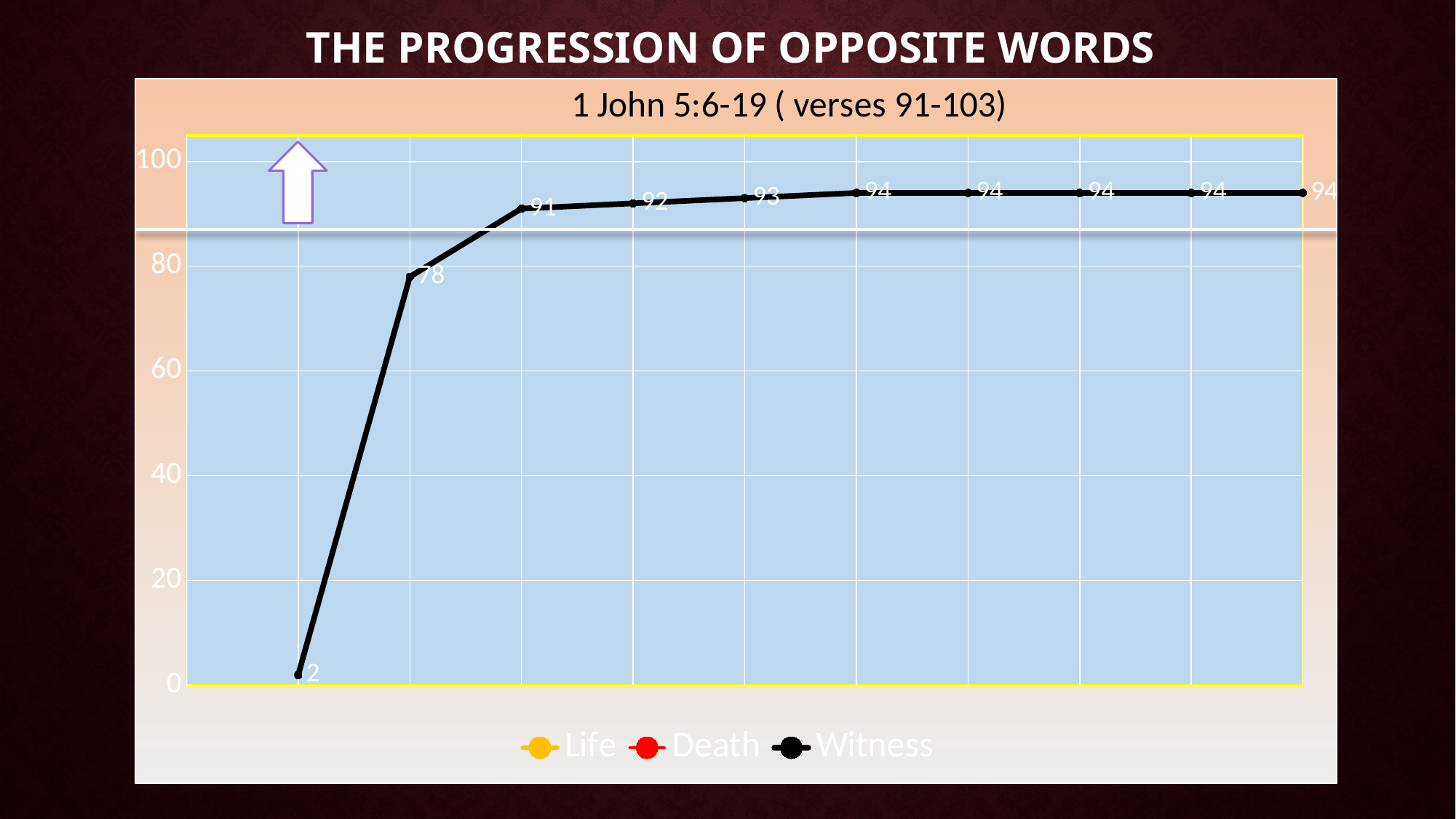
What is the value of the second plotted point on the Witness line? 78 What is the title shown inside the chart area? 1 John 5:6-19 ( verses 91-103) How many series does the legend list? 3 How many data points are labelled on the Witness line? 10 What is the highest value labelled on the Witness line? 94 What is the lowest value labelled on the Witness line? 2 Do the values on the Witness line rise or fall from left to right? rise What is the difference between the second point (78) and the first point (2) on the Witness line? 76 What is the value of the first plotted point on the Witness line? 2 What is the value of the last plotted point on the Witness line? 94 What is the difference between the third point (91) and the second point (78) on the Witness line? 13 What kind of chart is shown on the slide? line chart